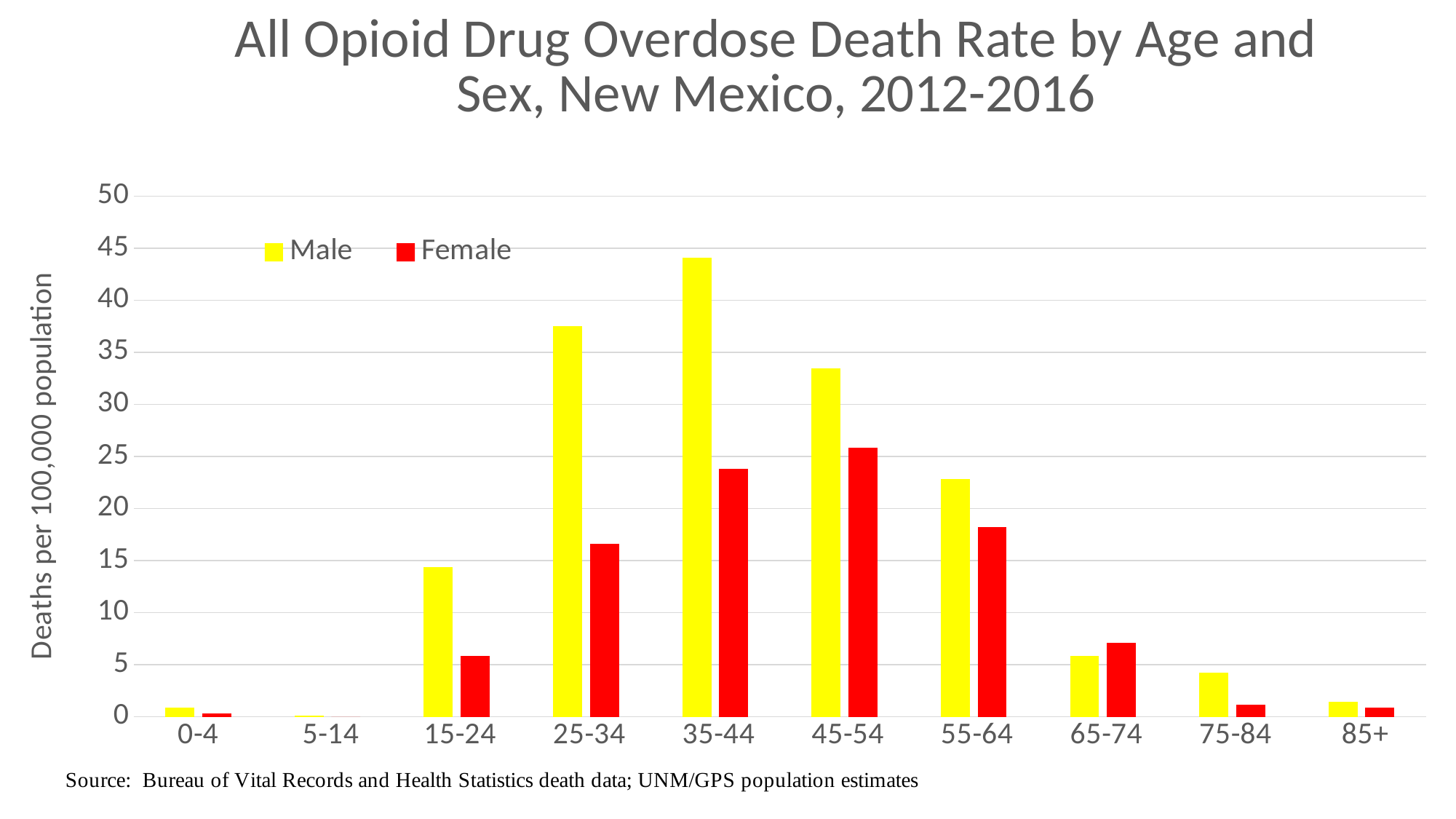
Which age group has the highest Female death rate? 45-54 For the 45-54 age group, which is larger, the Male or the Female death rate? Male Is the Male death rate for 55-64 greater or less than 20? greater Is the Male death rate for 35-44 greater or less than 40? greater How many series does the legend list? 2 Which age group has the highest Male death rate? 35-44 What colour represents the Female series? red What kind of chart is shown on the slide? bar chart For the 65-74 age group, which is larger, the Male or the Female death rate? Female Which age group has the lowest Male death rate? 5-14 Is the Female death rate for 25-34 greater or less than 20? less How many age groups are shown on the x axis? 10